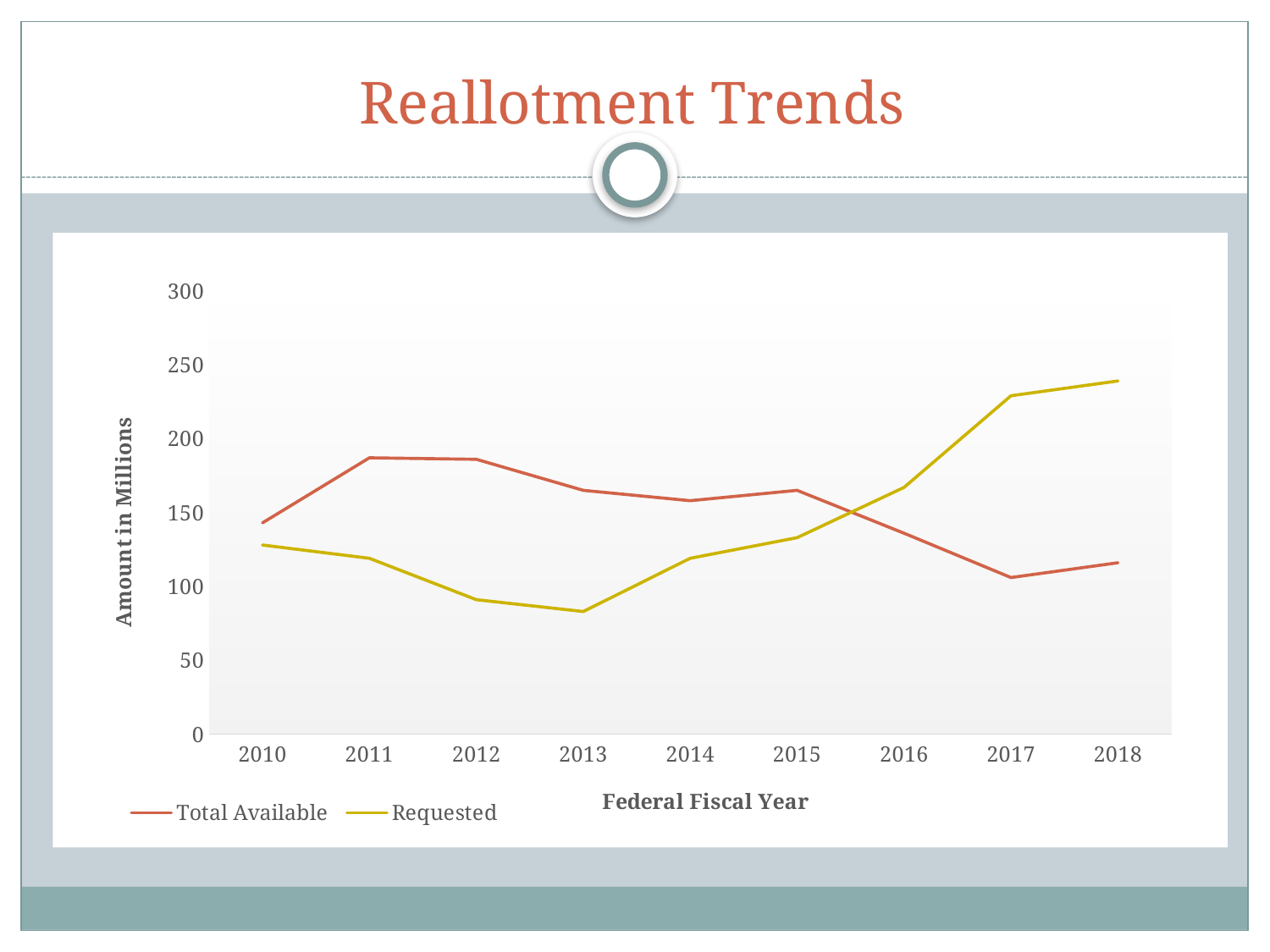
Is the Total Available value for 2011 greater or less than 150? greater In which year is the Requested series at its highest? 2018 What is the label on the y axis? Amount in Millions In which year is the Requested series at its lowest? 2013 Is the Total Available value for 2017 greater or less than 150? less Is the Requested value for 2018 greater or less than 200? greater What kind of chart is shown on the slide? line chart How many series does the legend list? 2 How many fiscal years are plotted along the x axis? 9 Does the Requested series rise or fall from 2013 to 2018? rise In 2017, which series has the larger value, Total Available or Requested? Requested